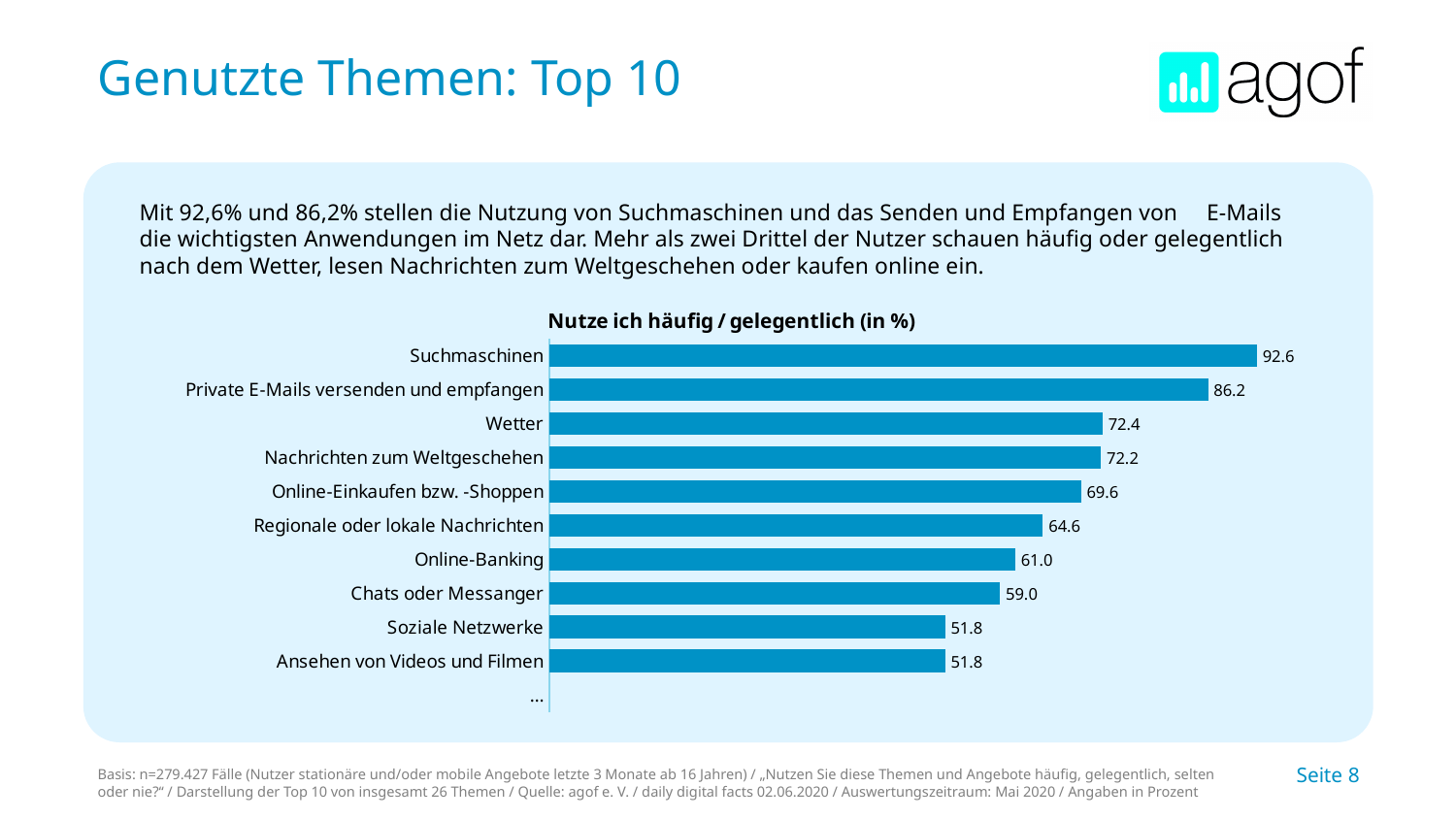
What is the value for Suchmaschinen? 92.6 What is the title of the chart? Nutze ich häufig / gelegentlich (in %) What kind of chart is shown on the slide? Bar chart What is the value for Ansehen von Videos und Filmen? 51.8 What is the value for Regionale oder lokale Nachrichten? 64.6 How many bars are plotted in the chart? 10 What is the difference between the values for Online-Banking and Chats oder Messanger? 2.0 What is the difference between the values for Suchmaschinen and Private E-Mails versenden und empfangen? 6.4 What is the value for Online-Banking? 61.0 Which category has the highest value? Suchmaschinen Which is larger, the value for Wetter or the value for Soziale Netzwerke? Wetter What is the value for Private E-Mails versenden und empfangen? 86.2